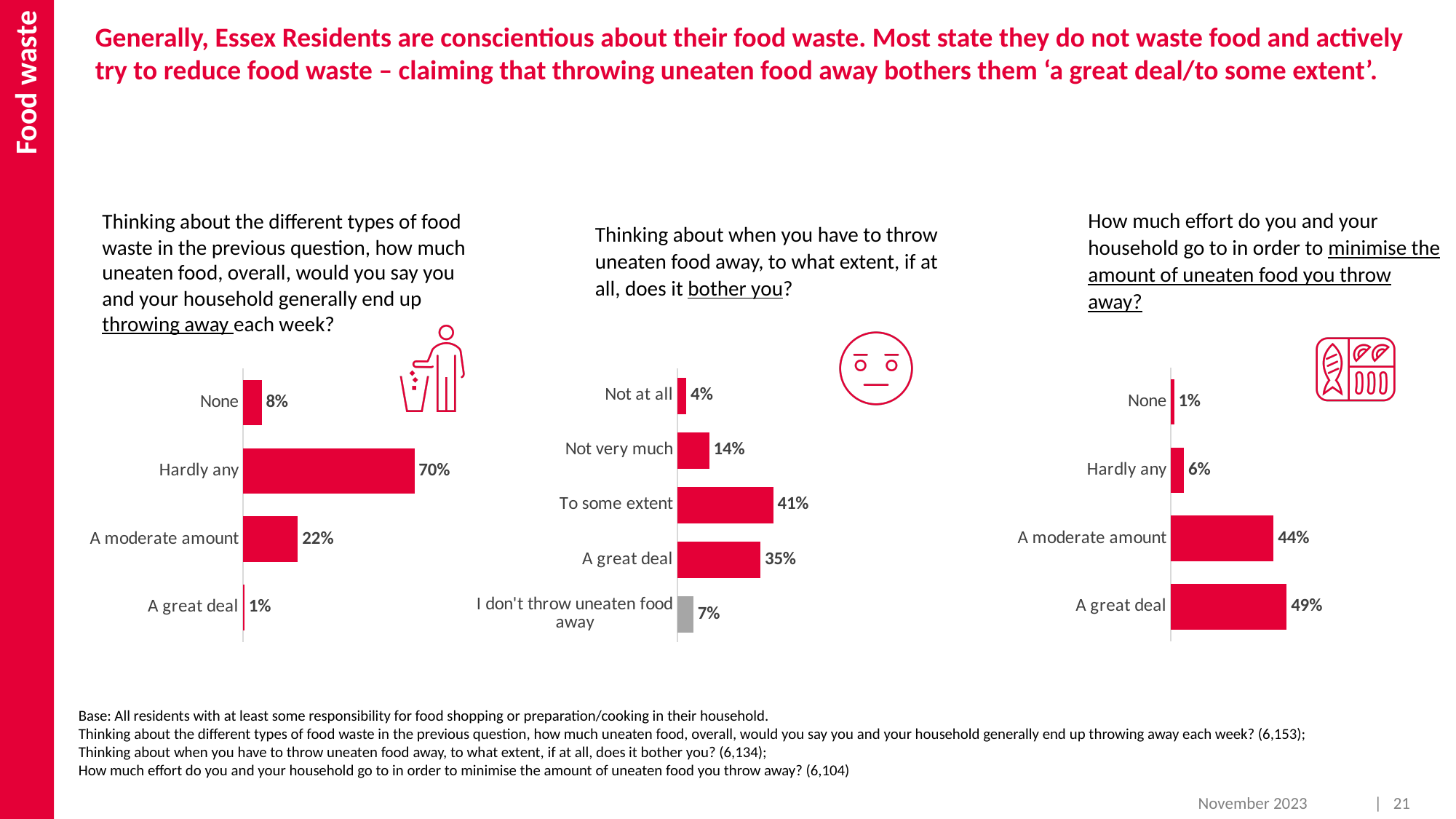
In the middle chart (to what extent does throwing uneaten food away bother you), which category has the highest value? To some extent In the right chart (how much effort to minimise uneaten food thrown away), what percentage said 'A moderate amount'? 44% In the middle chart (to what extent does throwing uneaten food away bother you), what percentage said 'To some extent'? 41% In the right chart (how much effort to minimise uneaten food thrown away), what is the difference between 'A great deal' and 'Hardly any'? 43% In the left chart (how much uneaten food is thrown away each week), what percentage of respondents said 'Hardly any'? 70% In the left chart (how much uneaten food is thrown away each week), which category has the lowest value? A great deal In the left chart (how much uneaten food is thrown away each week), what is the difference between 'Hardly any' and 'A moderate amount'? 48% What type of chart is used for the three charts on the slide? Bar chart In the left chart (how much uneaten food is thrown away each week), how many categories are shown? 4 In the middle chart (to what extent does throwing uneaten food away bother you), how many categories are shown? 5 In the right chart (how much effort to minimise uneaten food thrown away), which category has the highest value? A great deal In the middle chart (to what extent does throwing uneaten food away bother you), which is larger: 'Not very much' or 'A great deal'? A great deal